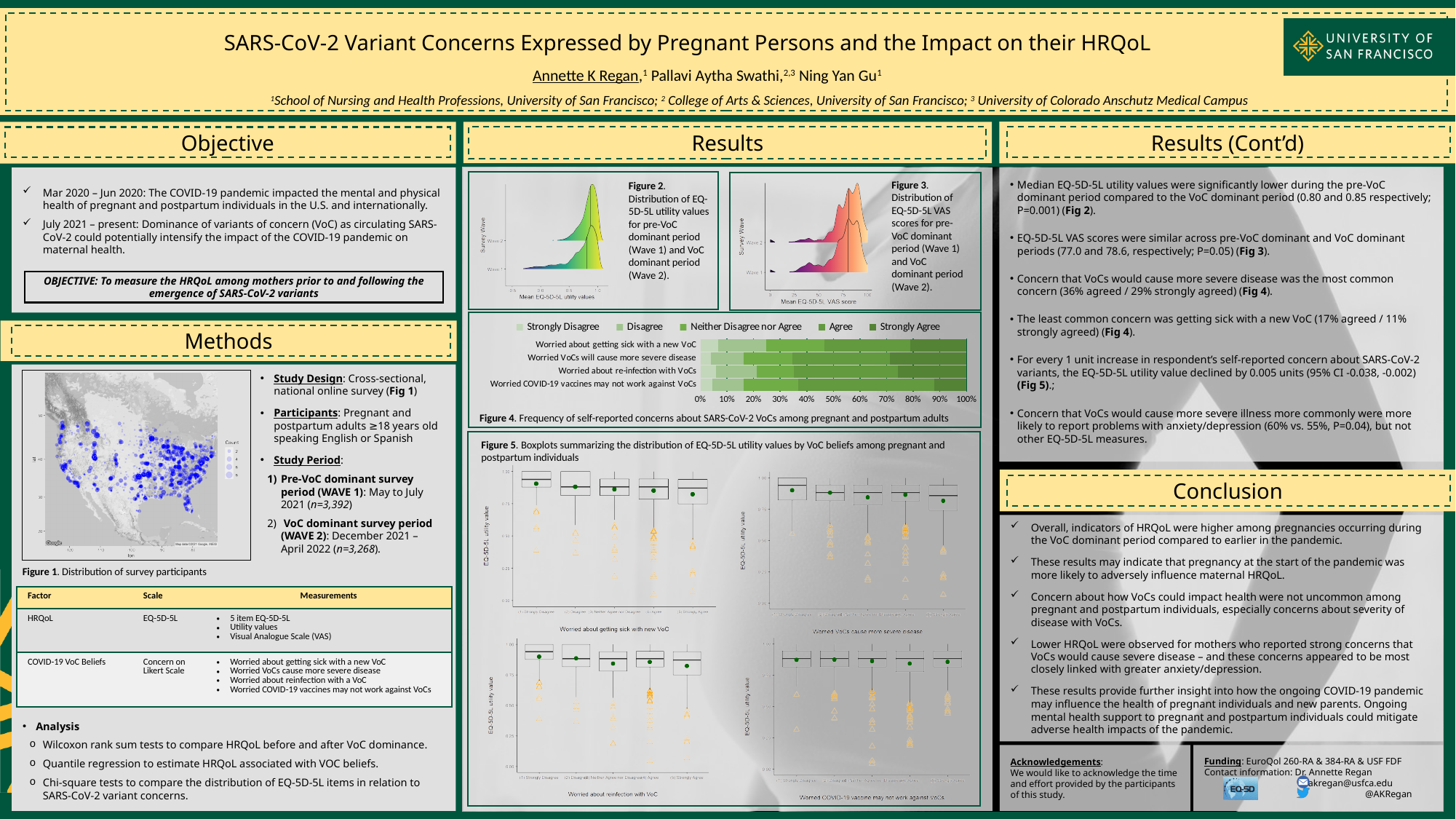
In Figure 4, is the combined Agree and Strongly Agree share for 'Worried VoCs will cause more severe disease' greater or less than 50%? greater What kind of chart is Figure 5 on the slide? Boxplot In Figure 4, is the Strongly Agree segment larger for 'Worried VoCs will cause more severe disease' or for 'Worried about getting sick with a new VoC'? Worried VoCs will cause more severe disease In Figure 4, what is the highest value shown on the horizontal axis? 100% In Figure 4, is the Strongly Disagree segment larger for 'Worried about getting sick with a new VoC' or for 'Worried VoCs will cause more severe disease'? Worried about getting sick with a new VoC In Figure 4, which legend entry is shown in the darkest green? Strongly Agree How many series does the legend of Figure 4 list? 5 What kind of chart is Figure 4 on the slide? Stacked bar chart In Figure 4, which category has the smallest combined Agree and Strongly Agree share? Worried about getting sick with a new VoC How many concern categories are plotted in Figure 4? 4